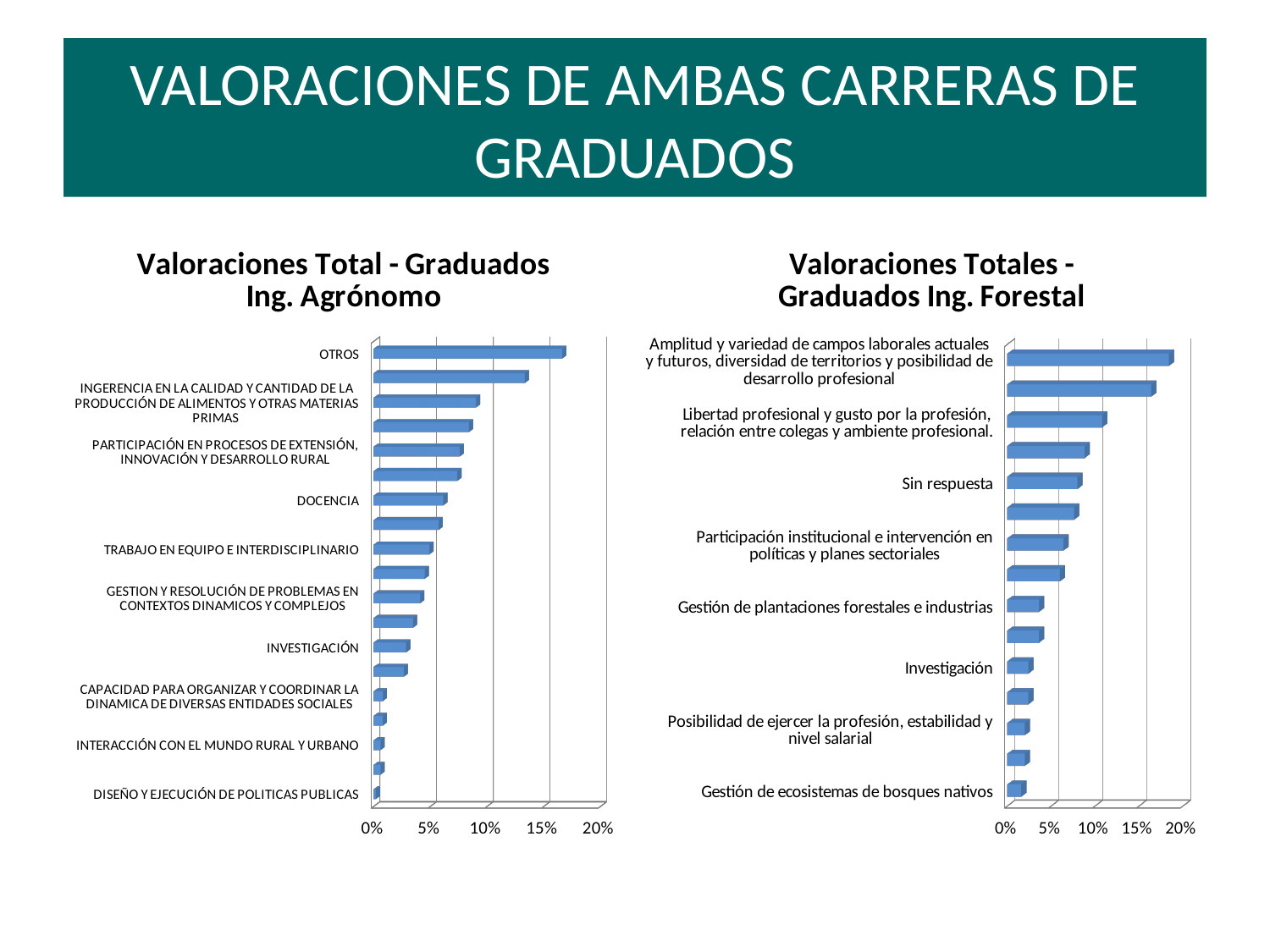
In the 'Valoraciones Total - Graduados Ing. Agrónomo' chart, which category has the highest value? OTROS In the 'Valoraciones Totales - Graduados Ing. Forestal' chart, which category has the highest value? Amplitud y variedad de campos laborales actuales y futuros, diversidad de territorios y posibilidad de desarrollo profesional In the 'Valoraciones Totales - Graduados Ing. Forestal' chart, is the value for 'Gestión de plantaciones forestales e industrias' greater or less than 5%? less In the 'Valoraciones Totales - Graduados Ing. Forestal' chart, which is larger: 'Sin respuesta' or 'Investigación'? Sin respuesta What type of chart is the 'Valoraciones Total - Graduados Ing. Agrónomo' chart? bar chart In the 'Valoraciones Total - Graduados Ing. Agrónomo' chart, which is larger: OTROS or DOCENCIA? OTROS In the 'Valoraciones Totales - Graduados Ing. Forestal' chart, which labeled category has the lowest value? Gestión de ecosistemas de bosques nativos In the 'Valoraciones Total - Graduados Ing. Agrónomo' chart, is the value for INVESTIGACIÓN greater or less than 5%? less In the 'Valoraciones Totales - Graduados Ing. Forestal' chart, is the value for 'Sin respuesta' greater or less than 10%? less In the 'Valoraciones Total - Graduados Ing. Agrónomo' chart, which labeled category has the lowest value? DISEÑO Y EJECUCIÓN DE POLITICAS PUBLICAS